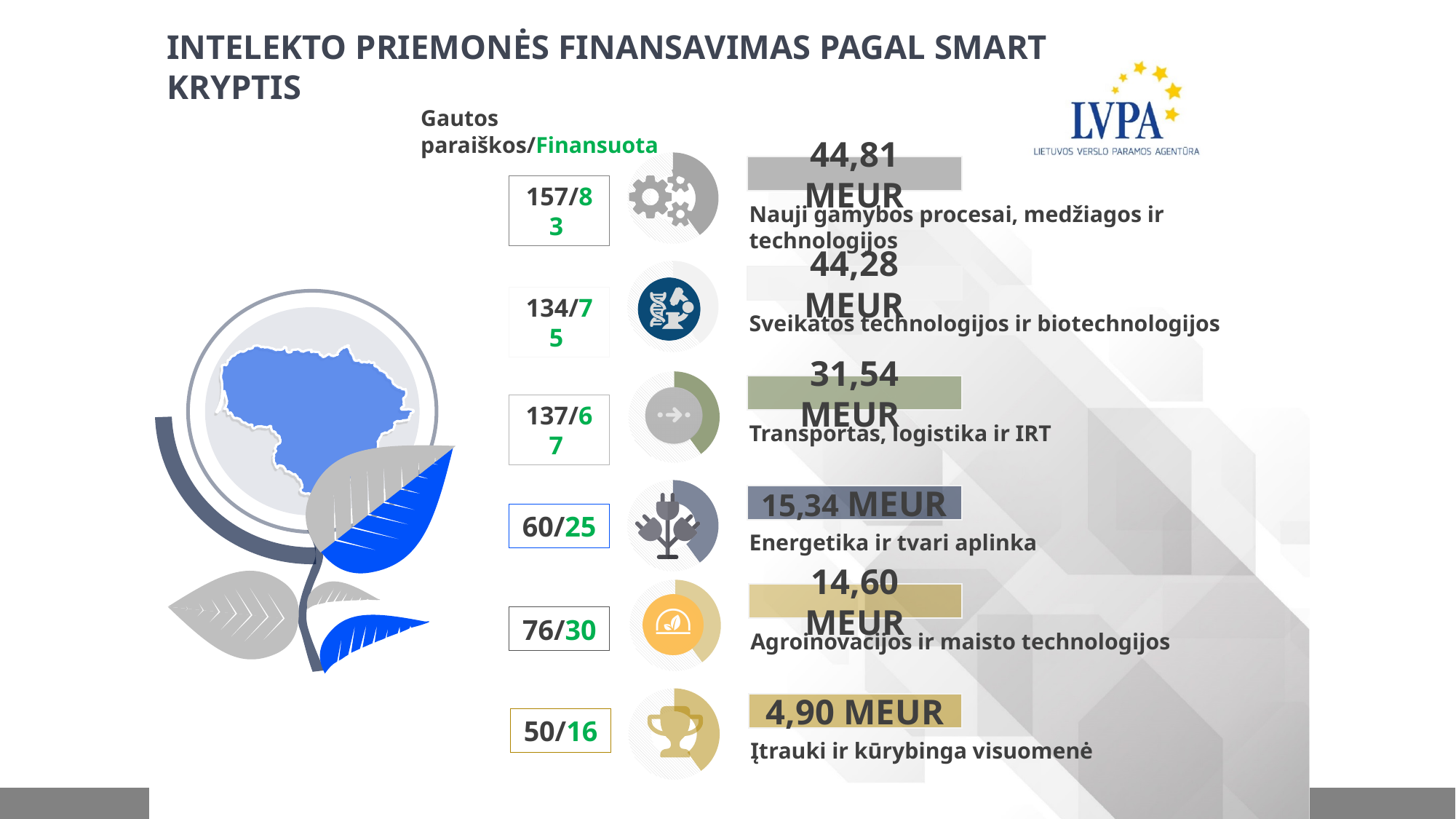
Which received more funding: Energetika ir tvari aplinka or Agroinovacijos ir maisto technologijos? Energetika ir tvari aplinka How many more applications were received than funded for Nauji gamybos procesai, medžiagos ir technologijos? 74 How many applications were funded (Finansuota) for Agroinovacijos ir maisto technologijos? 30 Which category has the highest funding amount? Nauji gamybos procesai, medžiagos ir technologijos What is the title of the slide? INTELEKTO PRIEMONĖS FINANSAVIMAS PAGAL SMART KRYPTIS What is the funding amount shown for Įtrauki ir kūrybinga visuomenė? 4,90 MEUR What is the funding amount shown for Transportas, logistika ir IRT? 31,54 MEUR How many applications were received (Gautos paraiškos) for Sveikatos technologijos ir biotechnologijos? 134 What is the difference in funding between Nauji gamybos procesai, medžiagos ir technologijos and Sveikatos technologijos ir biotechnologijos? 0,53 MEUR What is the funding amount shown for Energetika ir tvari aplinka? 15,34 MEUR Which category has the lowest funding amount? Įtrauki ir kūrybinga visuomenė How many SMART directions (categories) are shown on the slide? 6